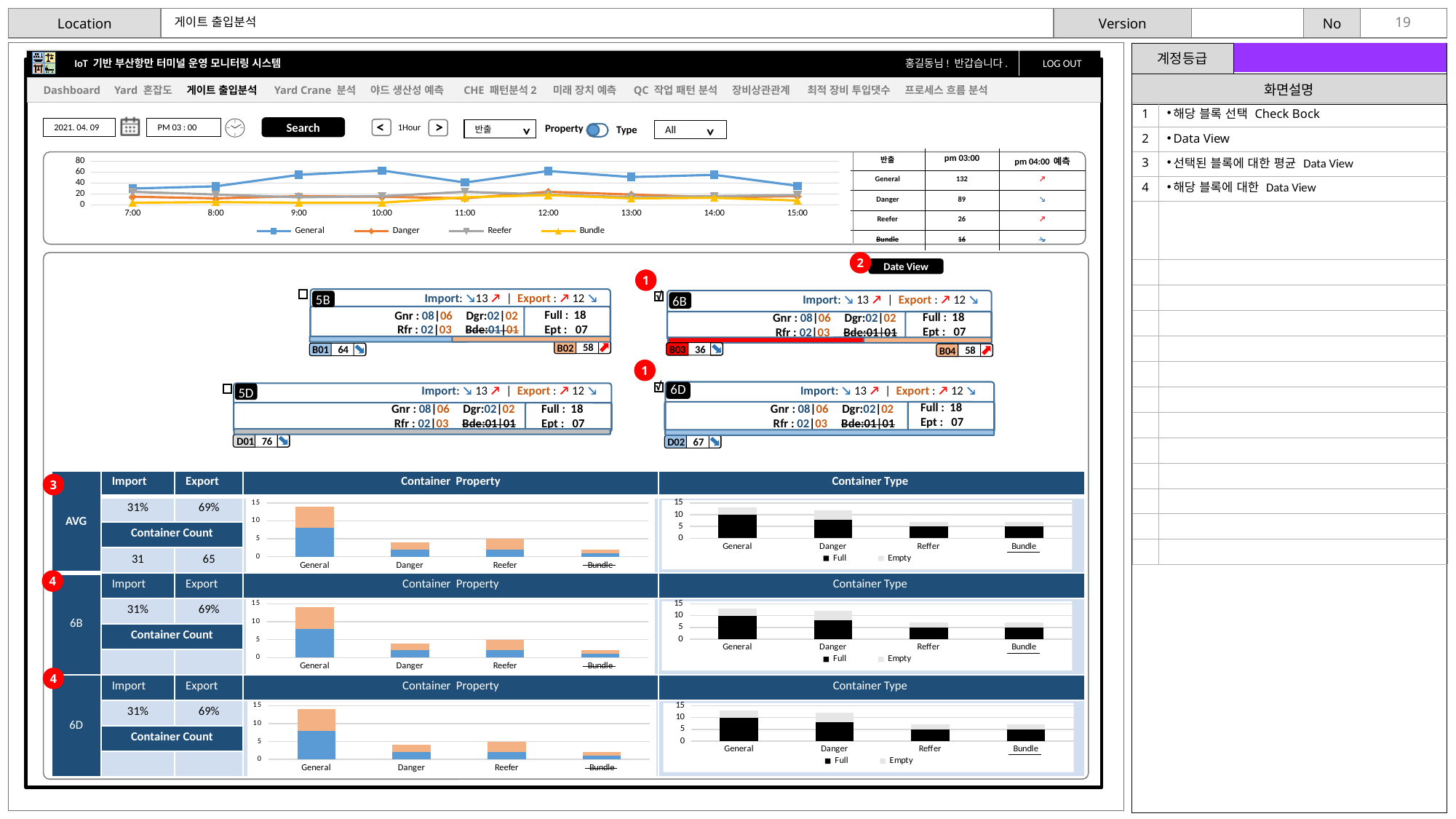
How many series does the legend of the AVG row's Container Type chart list? 2 In the AVG row's Container Property chart, which category has the tallest bar? General In the AVG row's Container Property chart, is the total for General greater or less than 10? greater In the top line chart, which is larger at 13:00, General or Bundle? General In the top line chart, is the value for General at 7:00 greater or less than 40? less In the AVG row's Container Property chart, which category has the shortest bar? Bundle In the top line chart, is the value for General at 10:00 greater or less than 40? greater In the top line chart, which series has the highest values across the time points? General How many series does the legend of the top line chart list? 4 What kind of chart is the chart at the top of the slide showing values from 7:00 to 15:00? line chart How many time points are plotted along the x axis of the top line chart? 9